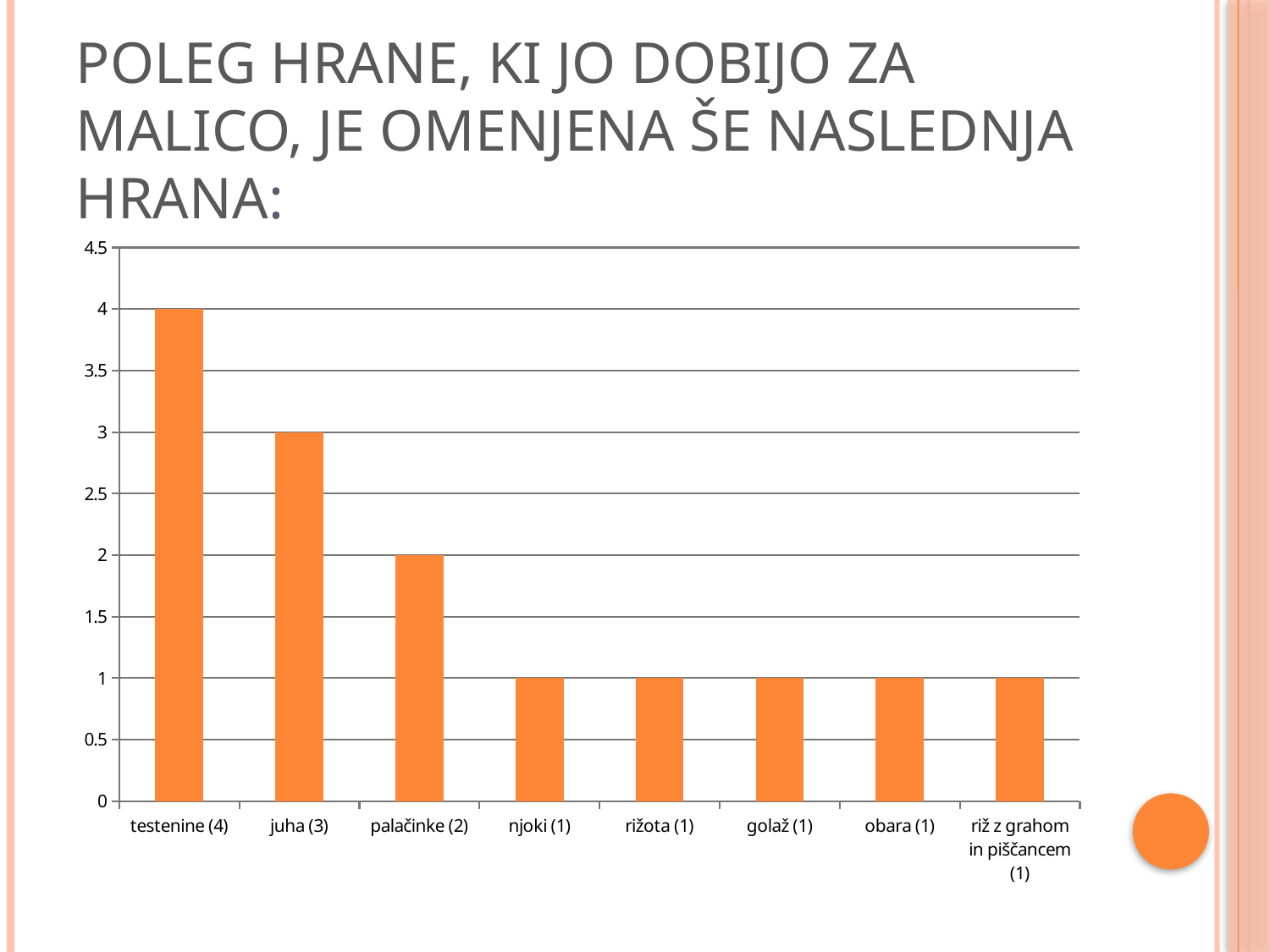
Which category has the highest value? testenine (4) What kind of chart is shown on the slide? bar chart What is the difference between the values for testenine (4) and juha (3)? 1 What is the value for juha (3)? 3 What is the value for palačinke (2)? 2 How many categories are shown on the x axis? 8 Is the value for testenine (4) greater or less than 3.5? greater What is the difference between the values for juha (3) and njoki (1)? 2 Which is larger, the value for palačinke (2) or the value for rižota (1)? palačinke (2) What is the value for golaž (1)? 1 Do the values rise or fall from left to right along the x axis? fall What is the value for testenine (4)? 4